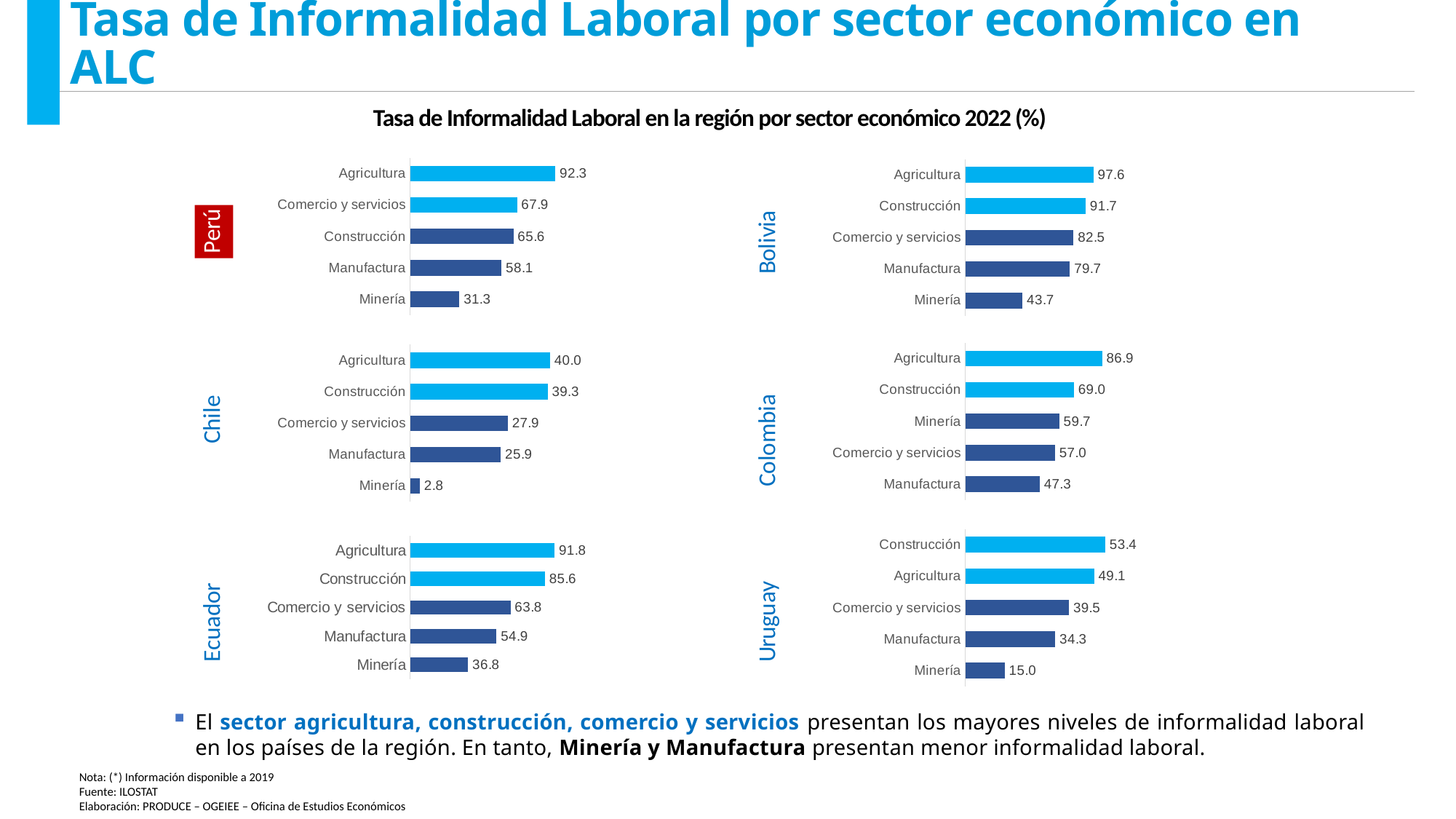
In the Ecuador chart, which is larger, Comercio y servicios or Manufactura? Comercio y servicios In the Colombia chart, which sector has the highest value? Agricultura In the Uruguay chart, which sector has the highest value? Construcción In the Bolivia chart, what is the value for Minería? 43.7 How many sectors are shown in the Perú chart? 5 What is the title of the chart area on the slide? Tasa de Informalidad Laboral en la región por sector económico 2022 (%) In the Colombia chart, what is the value for Manufactura? 47.3 In the Chile chart, what is the difference between Agricultura and Construcción? 0.7 In the Chile chart, which sector has the lowest value? Minería In the Uruguay chart, what is the difference between Construcción and Minería? 38.4 In the Perú chart, what is the value for Agricultura? 92.3 What kind of chart is used for each country on the slide? Bar chart